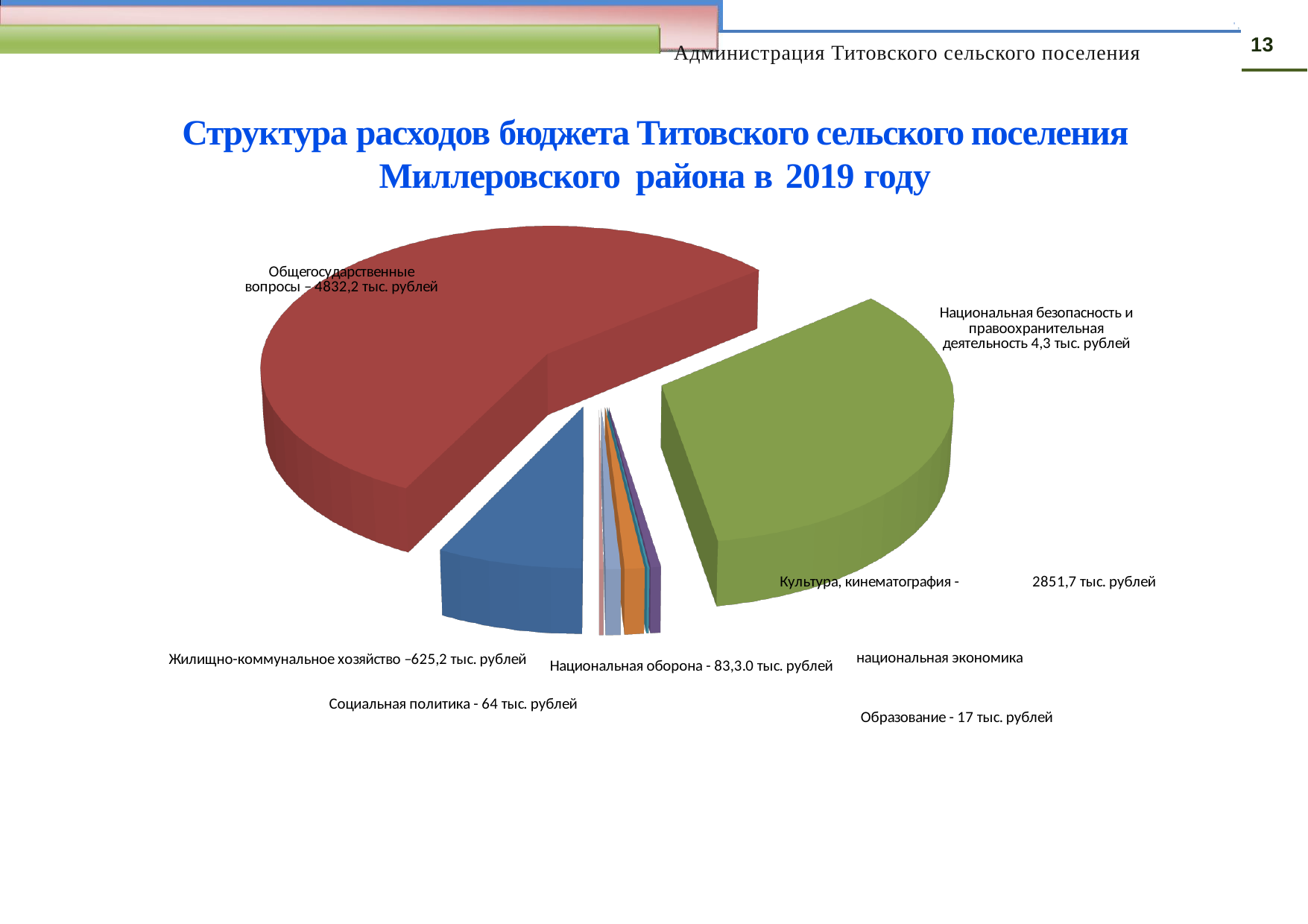
What is the value shown for Общегосударственные вопросы? 4832,2 тыс. рублей What is the difference between Общегосударственные вопросы and Культура, кинематография? 1980,5 тыс. рублей What is the value shown for Национальная безопасность и правоохранительная деятельность? 4,3 тыс. рублей What is the value shown for Жилищно-коммунальное хозяйство? 625,2 тыс. рублей What year does the chart title refer to? 2019 What is the value shown for Социальная политика? 64 тыс. рублей What kind of chart is shown on the slide? Pie chart Which is larger: Культура, кинематография or Жилищно-коммунальное хозяйство? Культура, кинематография Which expenditure category has the largest slice of the pie? Общегосударственные вопросы What is the value shown for Образование? 17 тыс. рублей Which category has the smallest printed value? Национальная безопасность и правоохранительная деятельность What is the value shown for Культура, кинематография? 2851,7 тыс. рублей